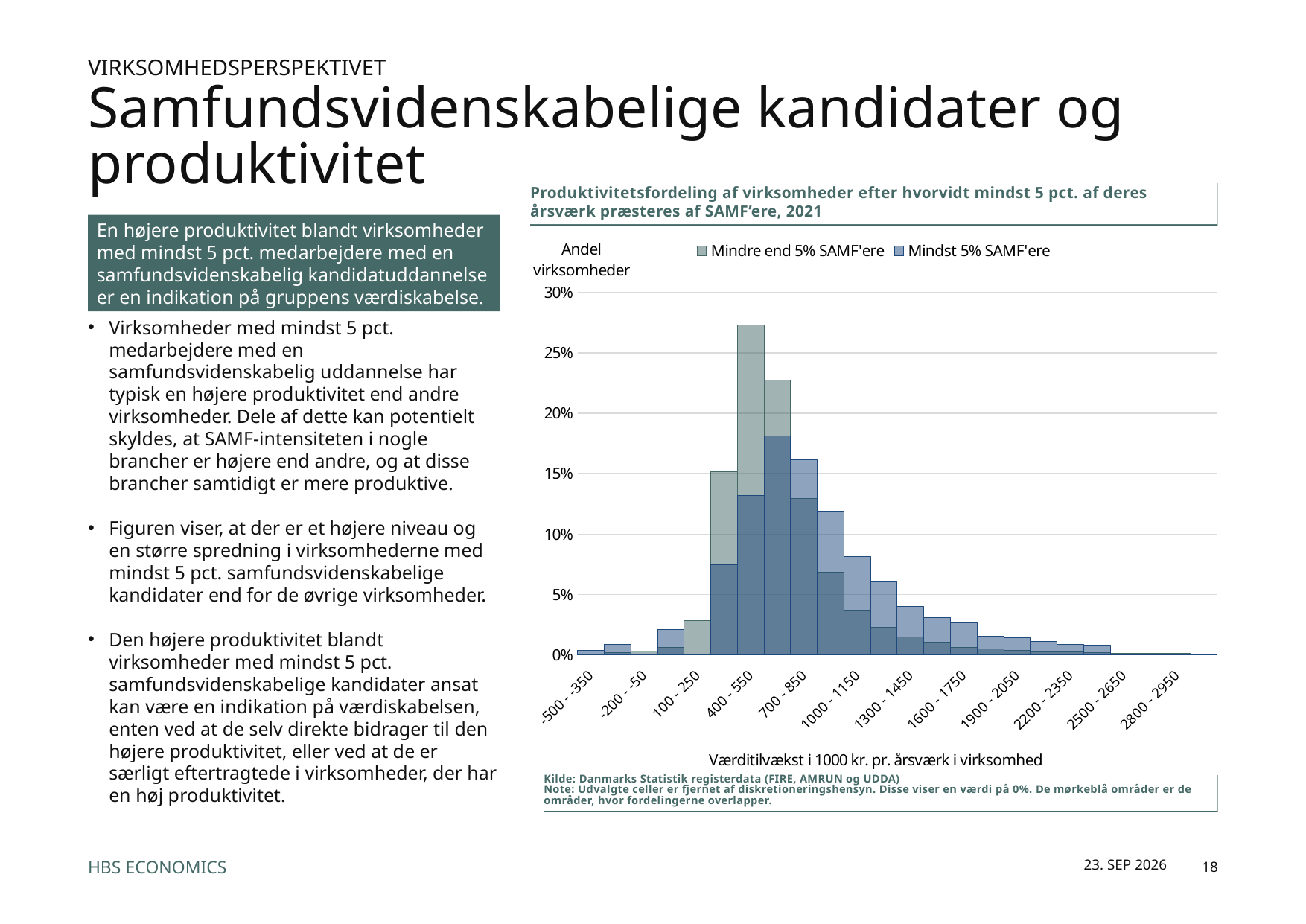
What kind of chart is shown on the slide? Bar chart Is the value for 'Mindst 5% SAMF'ere' at 700 - 850 greater or less than 20%? less Is the value for 'Mindst 5% SAMF'ere' at 1000 - 1150 greater or less than 10%? less Is the value for 'Mindre end 5% SAMF'ere' at 100 - 250 greater or less than 5%? less What is the x-axis label of the chart? Værditilvækst i 1000 kr. pr. årsværk i virksomhed At 1000 - 1150, which series has the larger value: 'Mindre end 5% SAMF'ere' or 'Mindst 5% SAMF'ere'? Mindst 5% SAMF'ere What are the two series named in the chart legend? Mindre end 5% SAMF'ere and Mindst 5% SAMF'ere For which x-axis category is the 'Mindre end 5% SAMF'ere' series highest? 400 - 550 For which x-axis category is the 'Mindst 5% SAMF'ere' series highest? 550 - 700 How many series does the chart legend list? 2 At 400 - 550, which series has the larger value: 'Mindre end 5% SAMF'ere' or 'Mindst 5% SAMF'ere'? Mindre end 5% SAMF'ere